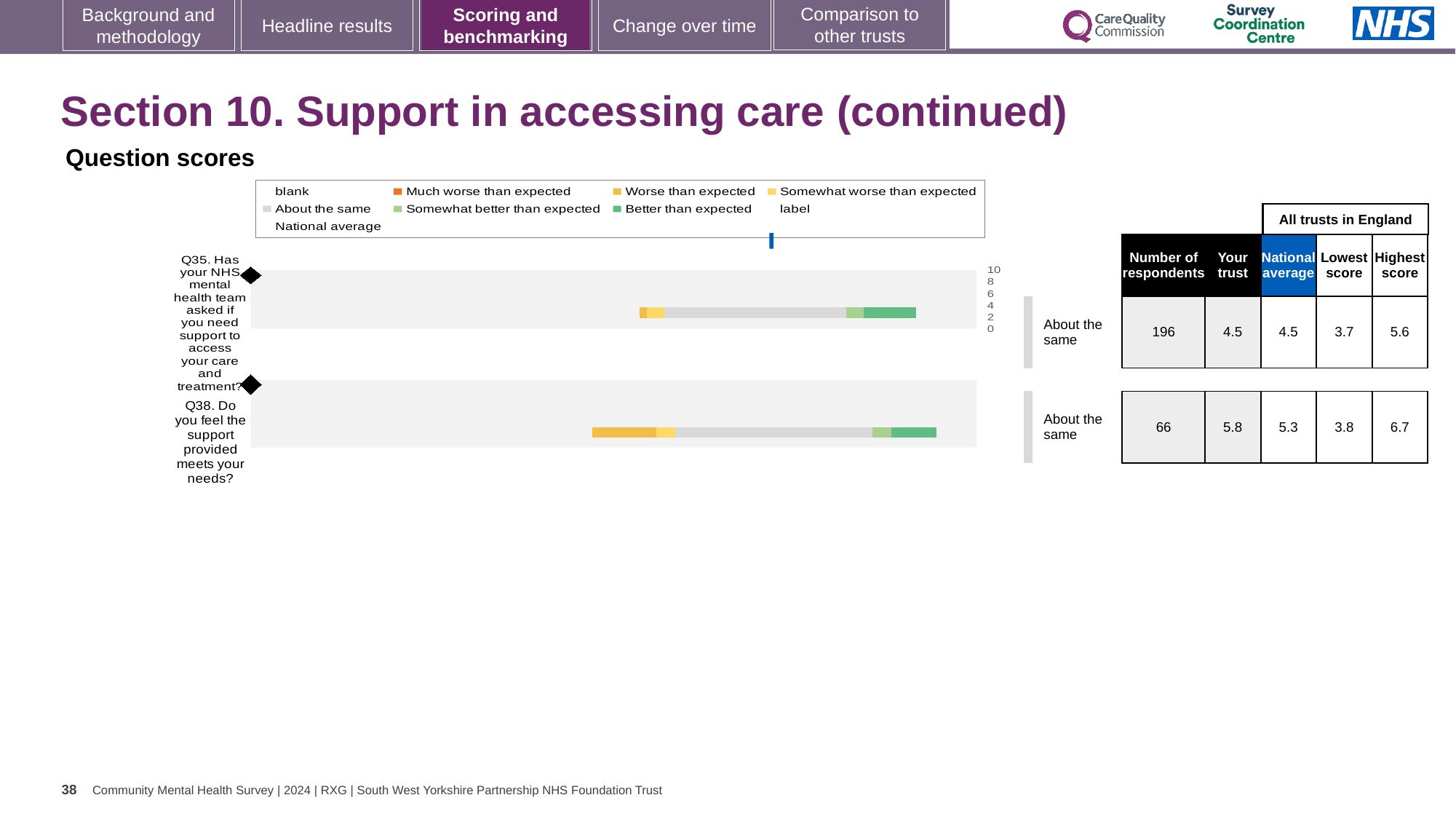
What is the maximum value shown on the chart's score axis? 10 How many questions are plotted on the chart? 2 What is the number of respondents for Q35? 196 What is the lowest score among all trusts in England for Q35? 3.7 What benchmark category is shown for Q35? About the same What is the national average for Q38? 5.3 What is the 'Your trust' score for Q38? 5.8 What kind of chart is used to show the question scores? bar chart What is the highest score among all trusts in England for Q38? 6.7 What is the difference between the 'Your trust' score and the national average for Q38? 0.5 What is the 'Your trust' score for Q35? 4.5 Which question has the higher 'Your trust' score, Q35 or Q38? Q38